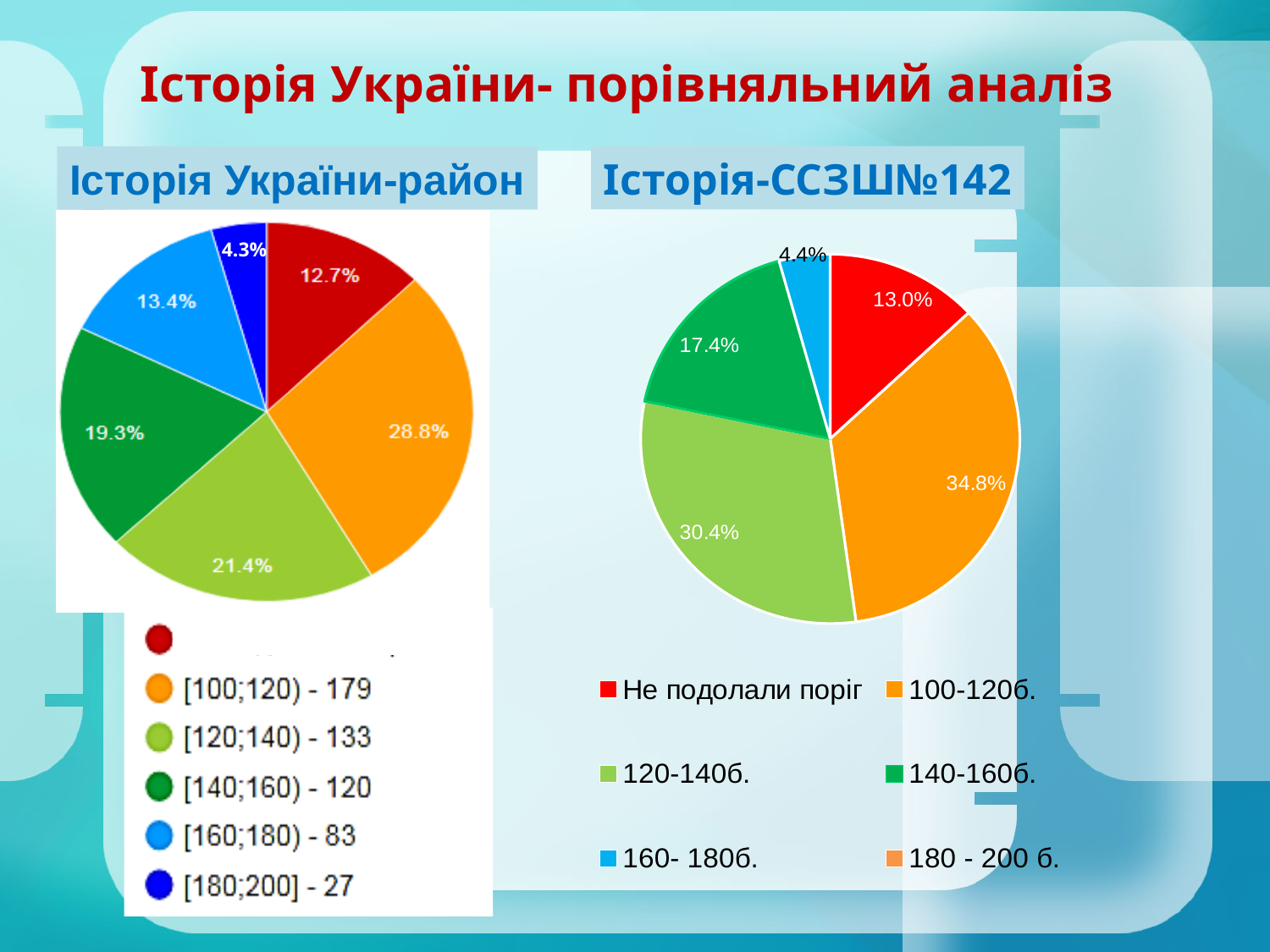
In the chart titled 'Історія-ССЗШ№142', which category has the largest slice? 100-120б. In the chart titled 'Історія-ССЗШ№142', which of the plotted slices is the smallest? 160- 180б. In the chart titled 'Історія України-район', which category has the largest slice? [100;120) In the chart titled 'Історія України-район', what is the difference in percentage points between the '[100;120)' slice and the '[120;140)' slice? 7.4% In the chart titled 'Історія-ССЗШ№142', what share does the 'Не подолали поріг' slice have? 13.0% In the chart titled 'Історія-ССЗШ№142', how many entries does the legend list? 6 What kind of chart is the chart titled 'Історія України-район'? pie chart In the chart titled 'Історія-ССЗШ№142', what share does the '100-120б.' slice have? 34.8% In the chart titled 'Історія України-район', what share does the '[140;160)' slice have? 19.3% In the chart titled 'Історія-ССЗШ№142', which slice is larger: '120-140б.' or '140-160б.'? 120-140б. In the chart titled 'Історія України-район', which category has the smallest slice? [180;200]